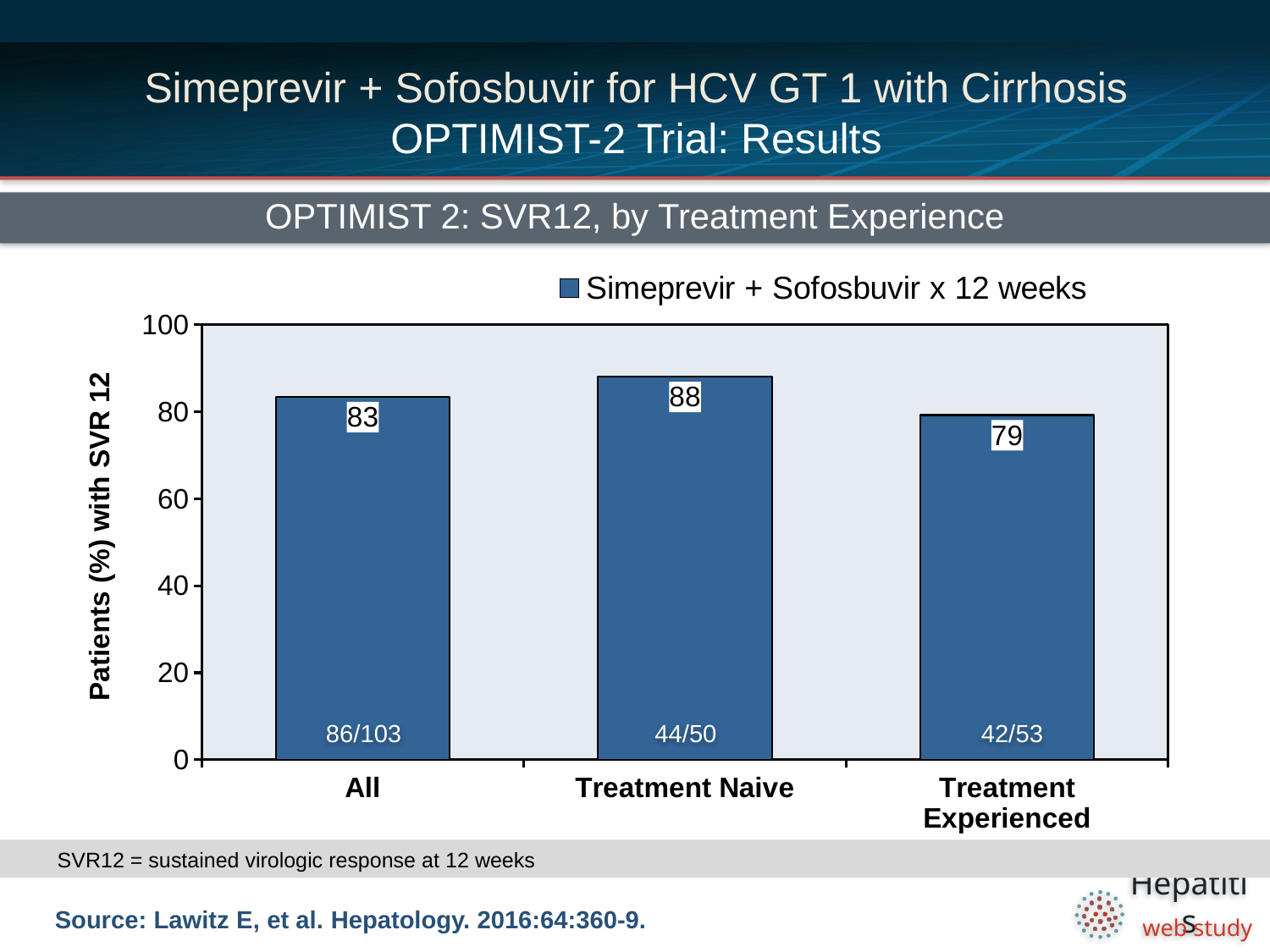
Which group has the lowest SVR12 rate? Treatment Experienced What is the SVR12 rate (%) for the Treatment Naive group? 88 What is the single series listed in the legend? Simeprevir + Sofosbuvir x 12 weeks What is the SVR12 rate (%) for the All group? 83 Which group has the highest SVR12 rate? Treatment Naive What fraction of patients is shown inside the bar for the Treatment Naive group? 44/50 Which group has a higher SVR12 rate, All or Treatment Experienced? All What is the difference in SVR12 rate between the Treatment Naive and Treatment Experienced groups? 9 What kind of chart is shown on the slide? Bar chart How many groups are shown on the x axis? 3 What fraction of patients is shown inside the bar for the All group? 86/103 What is the SVR12 rate (%) for the Treatment Experienced group? 79